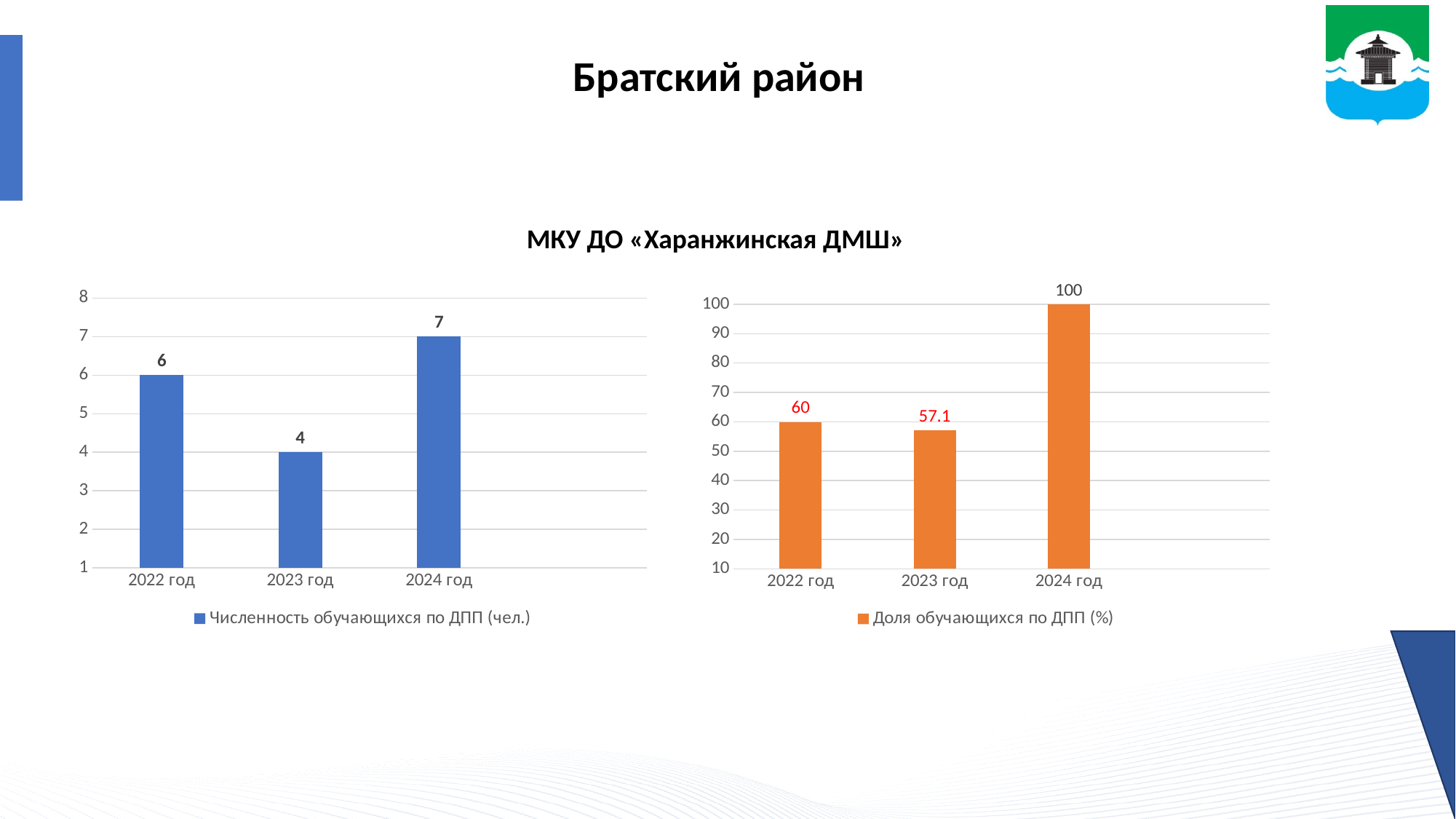
In the left chart (Численность обучающихся по ДПП), what is the difference between the values for 2024 год and 2023 год? 3 How many years are shown on the x axis of the right chart (Доля обучающихся по ДПП)? 3 In the left chart (Численность обучающихся по ДПП), what is the value for 2024 год? 7 In the right chart (Доля обучающихся по ДПП), what is the value for 2022 год? 60 What type of chart is the left chart (Численность обучающихся по ДПП)? bar chart In the left chart (Численность обучающихся по ДПП), which is larger: the value for 2022 год or 2024 год? 2024 год In the right chart (Доля обучающихся по ДПП), what is the difference between the values for 2024 год and 2022 год? 40 In the right chart (Доля обучающихся по ДПП), which year has the highest value? 2024 год In the right chart (Доля обучающихся по ДПП), what is the value for 2023 год? 57.1 What is the legend entry of the right chart? Доля обучающихся по ДПП (%) In the left chart (Численность обучающихся по ДПП), what is the value for 2023 год? 4 In the left chart (Численность обучающихся по ДПП), which year has the lowest value? 2023 год